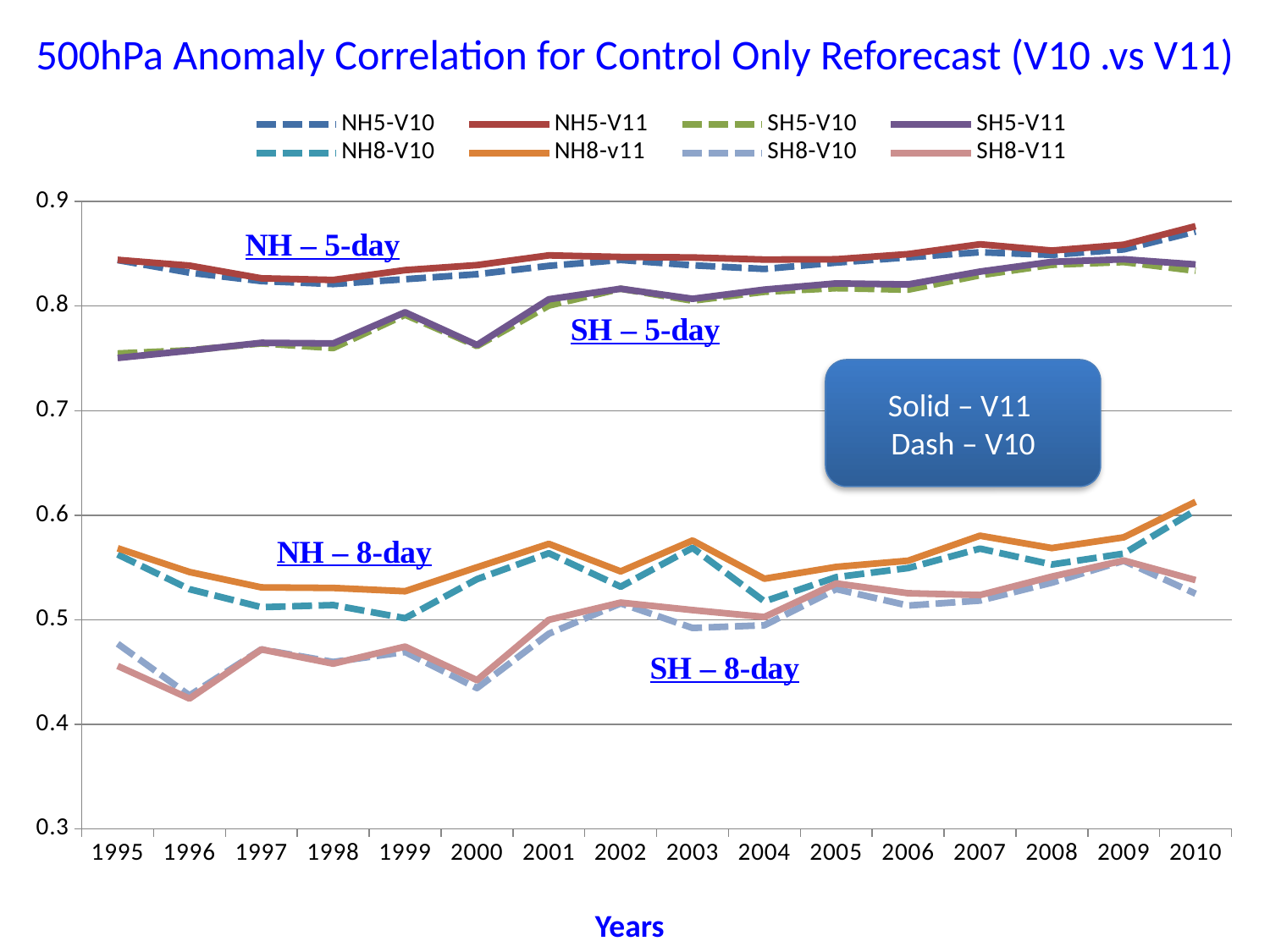
In 1995, which is larger: NH5-V11 or SH5-V11? NH5-V11 Is the value for NH5-V11 in 2010 greater or less than 0.8? greater Is the value for SH5-V11 in 1995 greater or less than 0.8? less How many years are plotted along the x axis? 16 What kind of chart is shown on the slide? line chart Does the SH5-V11 series rise or fall overall from 1995 to 2010? rise What is the title of the chart? 500hPa Anomaly Correlation for Control Only Reforecast (V10 .vs V11) How many series does the legend list? 8 Is the value for SH8-V10 in 1996 greater or less than 0.5? less What is the label of the x axis? Years In which year does NH5-V11 reach its highest value? 2010